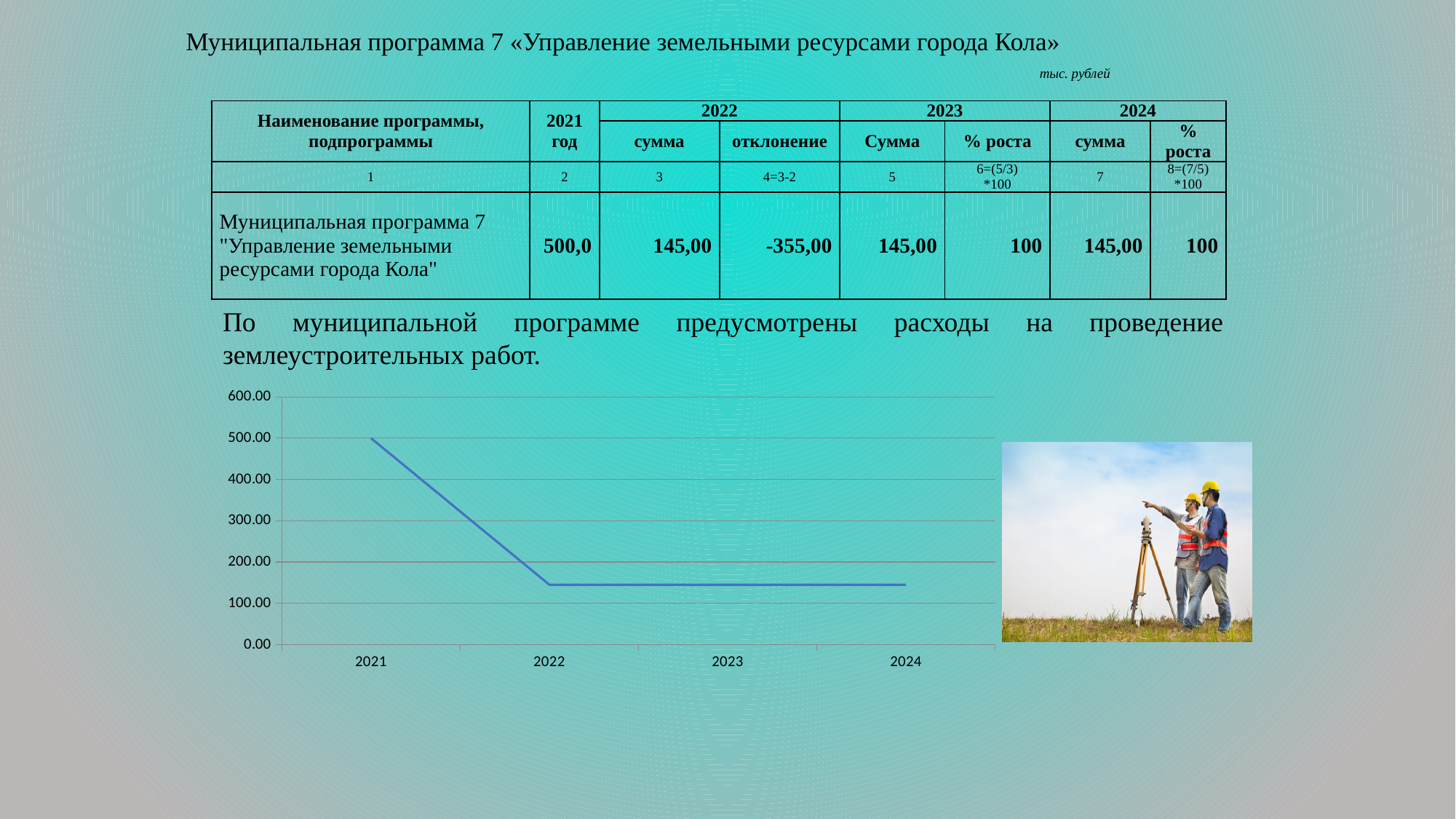
Which is larger on the chart, the value for 2021 or the value for 2024? 2021 Is the value for 2022 on the chart greater or less than 200.00? less What kind of chart is shown on the slide? line chart What is the value plotted for 2021 on the chart? 500.00 Is the value for 2021 on the chart greater or less than 400.00? greater What is the first year shown on the x axis of the chart? 2021 How does the line on the chart change from 2021 to 2024? falls sharply from 2021 to 2022, then stays flat Which year has the highest value on the chart? 2021 How many years are plotted along the x axis of the chart? 4 Is the value for 2023 on the chart greater or less than 100.00? greater What is the highest tick value shown on the y axis of the chart? 600.00